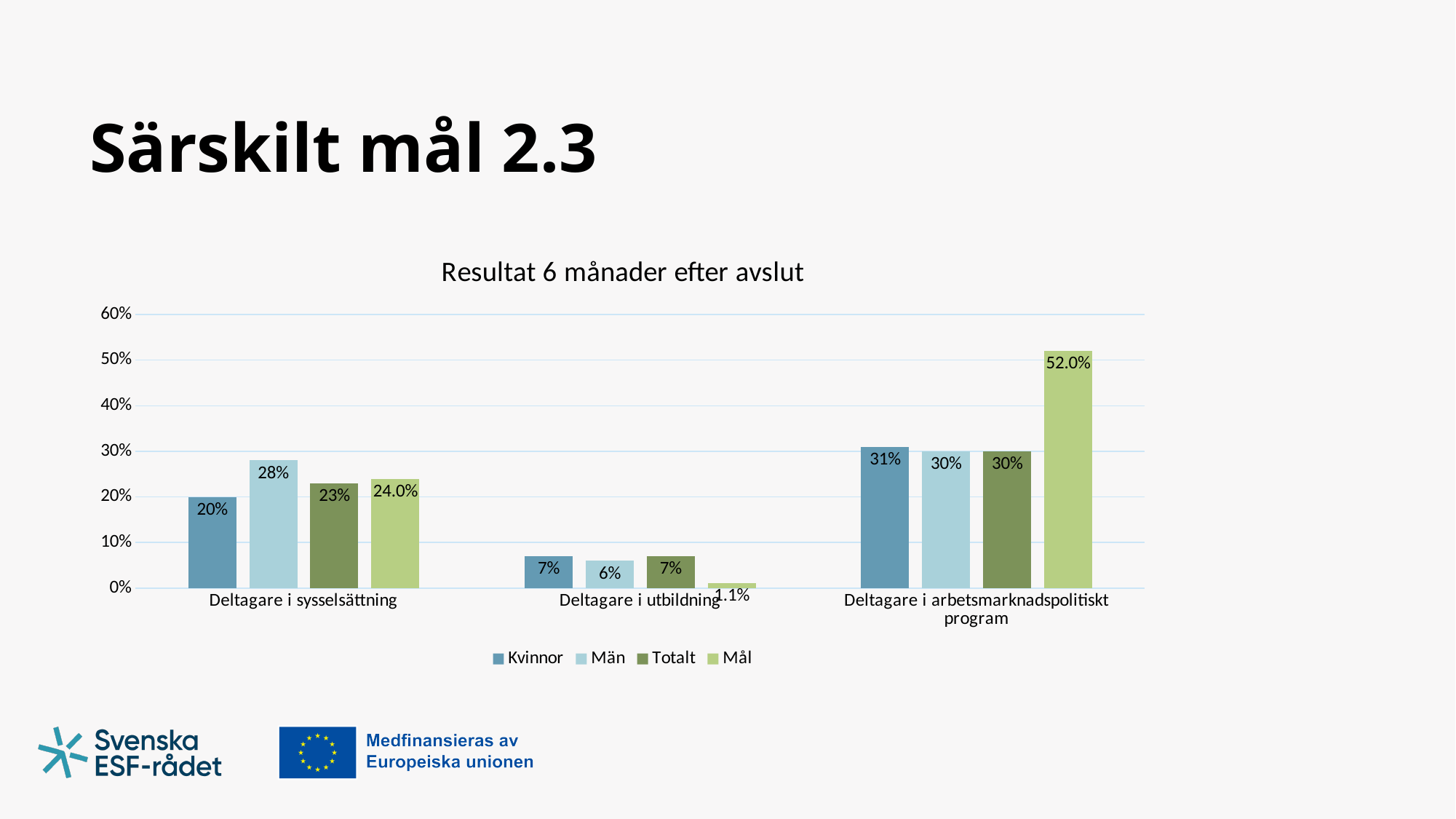
What kind of chart is shown on the slide? Bar chart Which category has the lowest Totalt value? Deltagare i utbildning How many series does the legend list? 4 What is the value for Kvinnor in the 'Deltagare i sysselsättning' category? 20% In the 'Deltagare i sysselsättning' category, which is larger: the value for Kvinnor or the value for Män? Män What is the value for Män in the 'Deltagare i utbildning' category? 6% What is the Mål value for 'Deltagare i utbildning'? 1.1% What is the Mål value for 'Deltagare i arbetsmarknadspolitiskt program'? 52.0% How many categories are shown on the x axis? 3 Which category has the highest Mål value? Deltagare i arbetsmarknadspolitiskt program What is the difference between the Mål value and the Totalt value for 'Deltagare i arbetsmarknadspolitiskt program'? 22.0% What is the title of the chart? Resultat 6 månader efter avslut